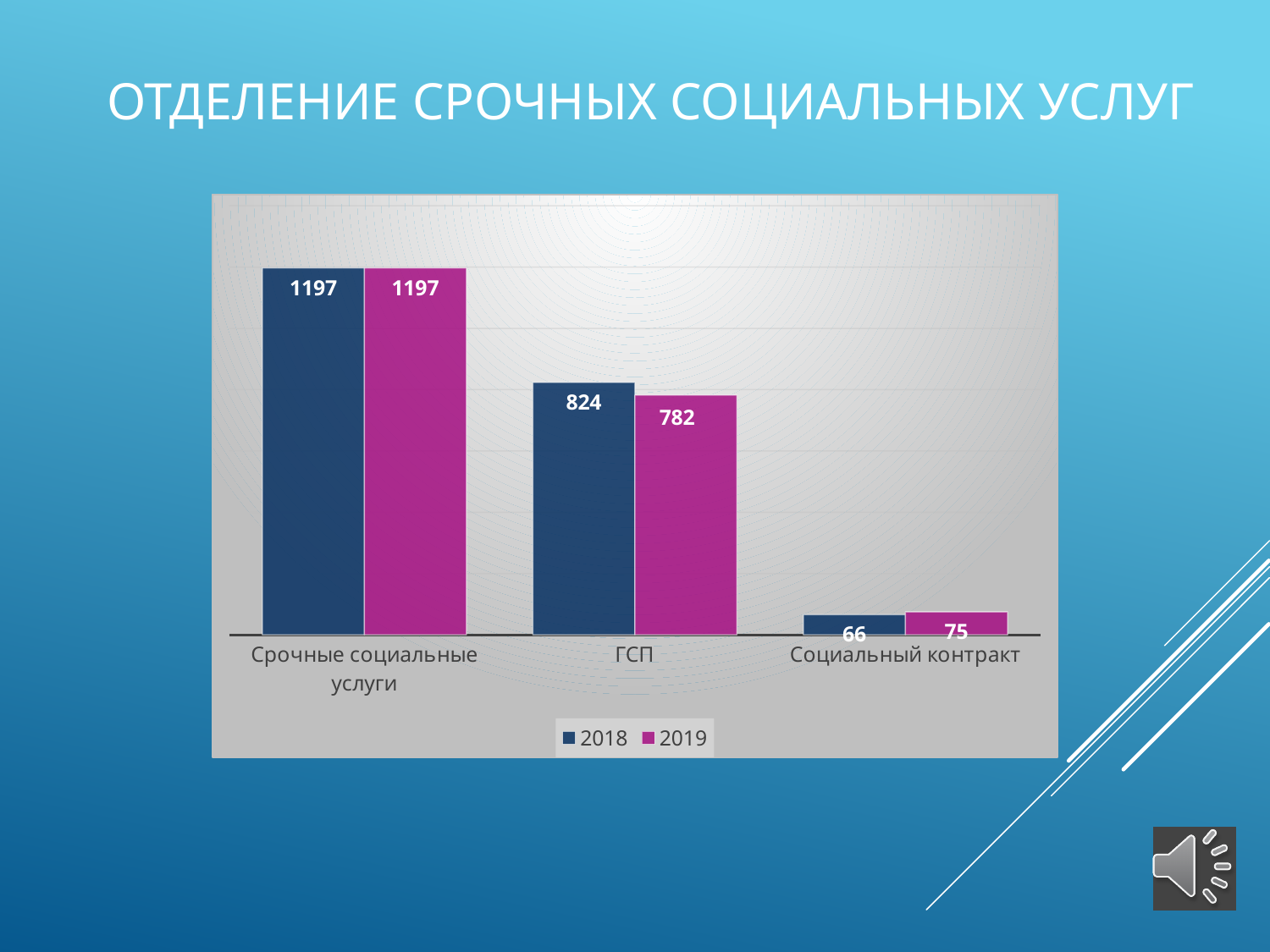
What is the value for ГСП in 2019? 782 What is the difference between the 2018 and 2019 values for ГСП? 42 What is the value for Социальный контракт in 2019? 75 How many categories are shown on the x axis? 3 What is the value for Социальный контракт in 2018? 66 Which category has the lowest value in 2018? Социальный контракт Which category has the highest value in 2019? Срочные социальные услуги What is the difference between the 2019 and 2018 values for Социальный контракт? 9 Which is larger for ГСП: the 2018 value or the 2019 value? 2018 What kind of chart is shown on the slide? Bar chart What is the value for Срочные социальные услуги in 2018? 1197 How many series does the legend list? 2